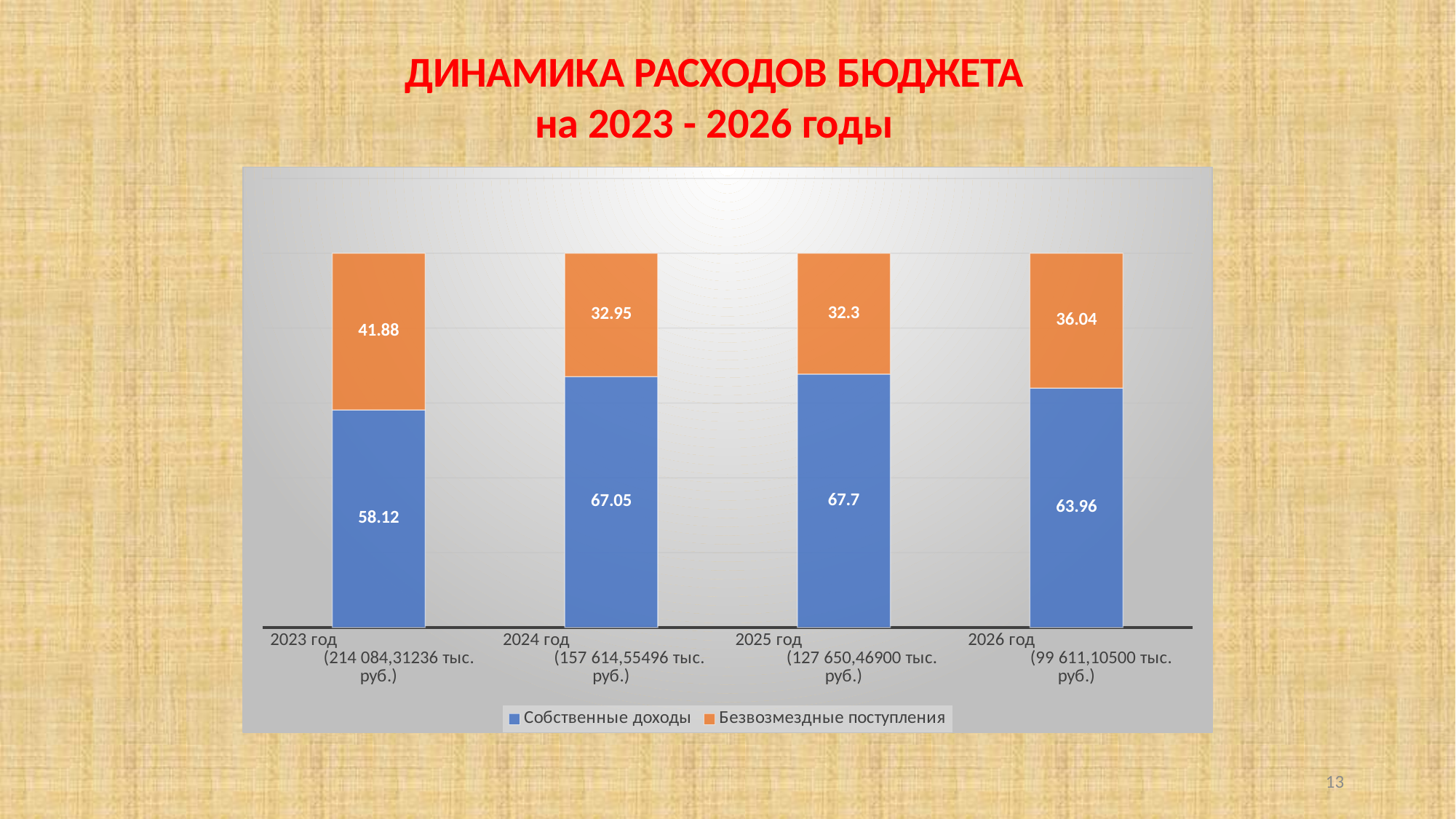
How many years are shown on the x axis? 4 What is the difference between Собственные доходы and Безвозмездные поступления for 2023 год? 16.24 In which year is Безвозмездные поступления highest? 2023 год What is the total of the stacked bar for 2024 год? 100 Which is larger for 2026 год: Собственные доходы or Безвозмездные поступления? Собственные доходы What is the value of Безвозмездные поступления for 2024 год? 32.95 In which year is Собственные доходы lowest? 2023 год What is the value of Безвозмездные поступления for 2026 год? 36.04 What kind of chart is shown on the slide? Stacked bar chart What is the value of Собственные доходы for 2025 год? 67.7 What is the value of Собственные доходы for 2023 год? 58.12 How many series does the legend list? 2